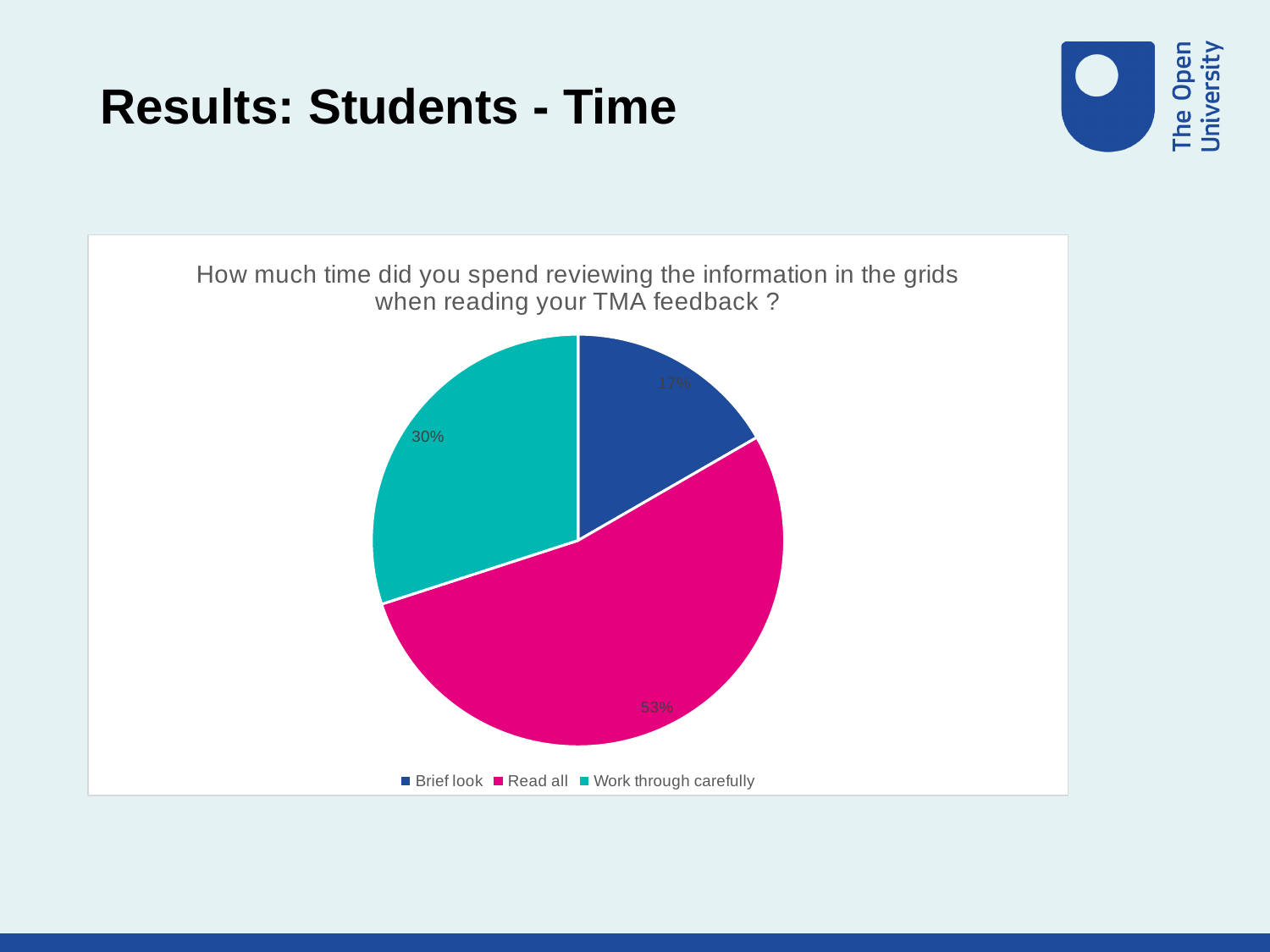
What is the difference in percentage points between 'Work through carefully' and 'Brief look'? 13 What percentage of students said they read all of the grids? 53% How many categories does the pie chart show? 3 What colour is the 'Read all' slice? pink What is the title of the chart? How much time did you spend reviewing the information in the grids when reading your TMA feedback ? What percentage of students said they took a brief look at the grids? 17% Which is larger, the share for 'Work through carefully' or the share for 'Brief look'? Work through carefully What kind of chart is shown on the slide? pie chart How many percentage points larger is the 'Read all' share than the 'Work through carefully' share? 23 What percentage of students said they worked through the grids carefully? 30% Which response has the largest share of the pie? Read all Which response has the smallest share of the pie? Brief look